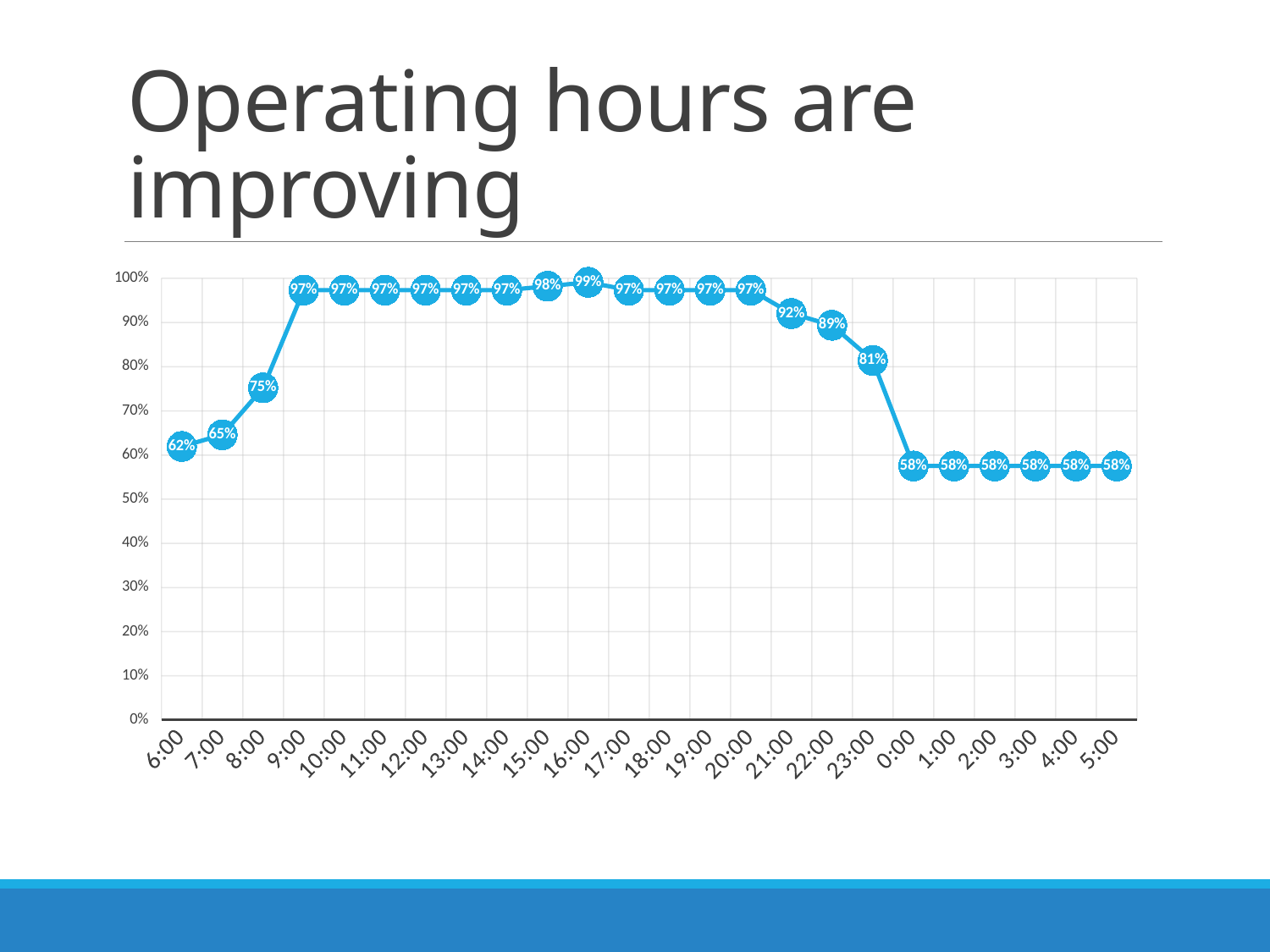
What is the difference between the values at 16:00 and 6:00? 37% What is the value at 23:00? 81% What is the title of the slide? Operating hours are improving How many data points are plotted on the chart? 24 At which time is the value highest? 16:00 What is the value at 8:00? 75% What is the value at 6:00? 62% What is the difference between the values at 21:00 and 22:00? 3% What is the lowest value shown on the chart? 58% Which is larger, the value at 7:00 or the value at 23:00? 23:00 What type of chart is shown on the slide? line chart What is the value at 22:00? 89%